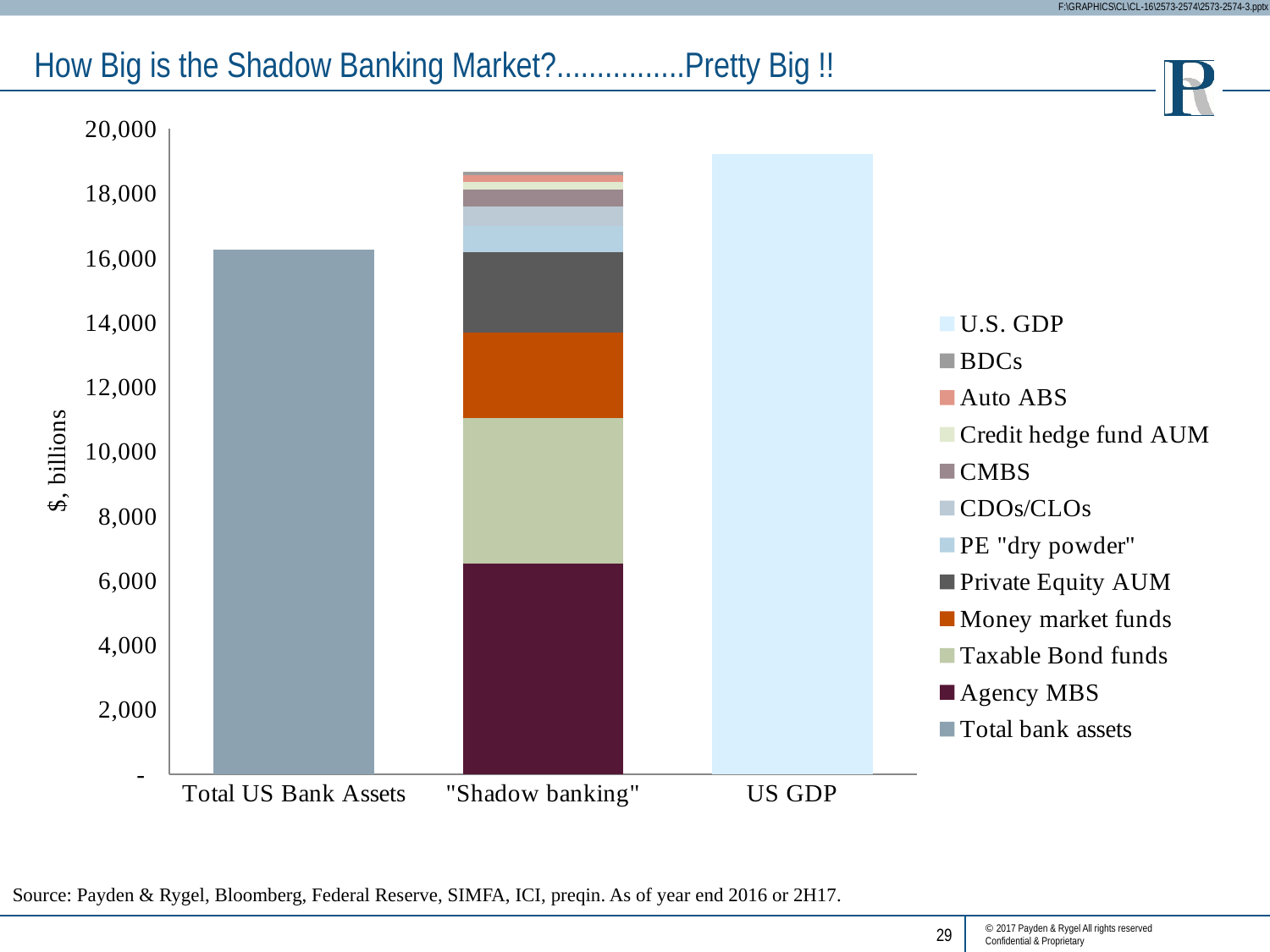
How many categories are shown on the x axis of the chart? 3 Is the Agency MBS segment of the "Shadow banking" bar greater or less than 8,000? less Is the total height of the "Shadow banking" bar greater or less than 18,000? greater What is the label on the y axis of the chart? $, billions How many series does the chart's legend list? 12 What kind of chart is shown on the slide? Stacked bar chart Is the value for US GDP greater or less than 18,000? greater Which is larger, the bar for Total US Bank Assets or the bar for "Shadow banking"? "Shadow banking" Which category has the tallest bar in the chart? US GDP Which category has the shortest bar in the chart? Total US Bank Assets Which series forms the bottom segment of the "Shadow banking" bar? Agency MBS